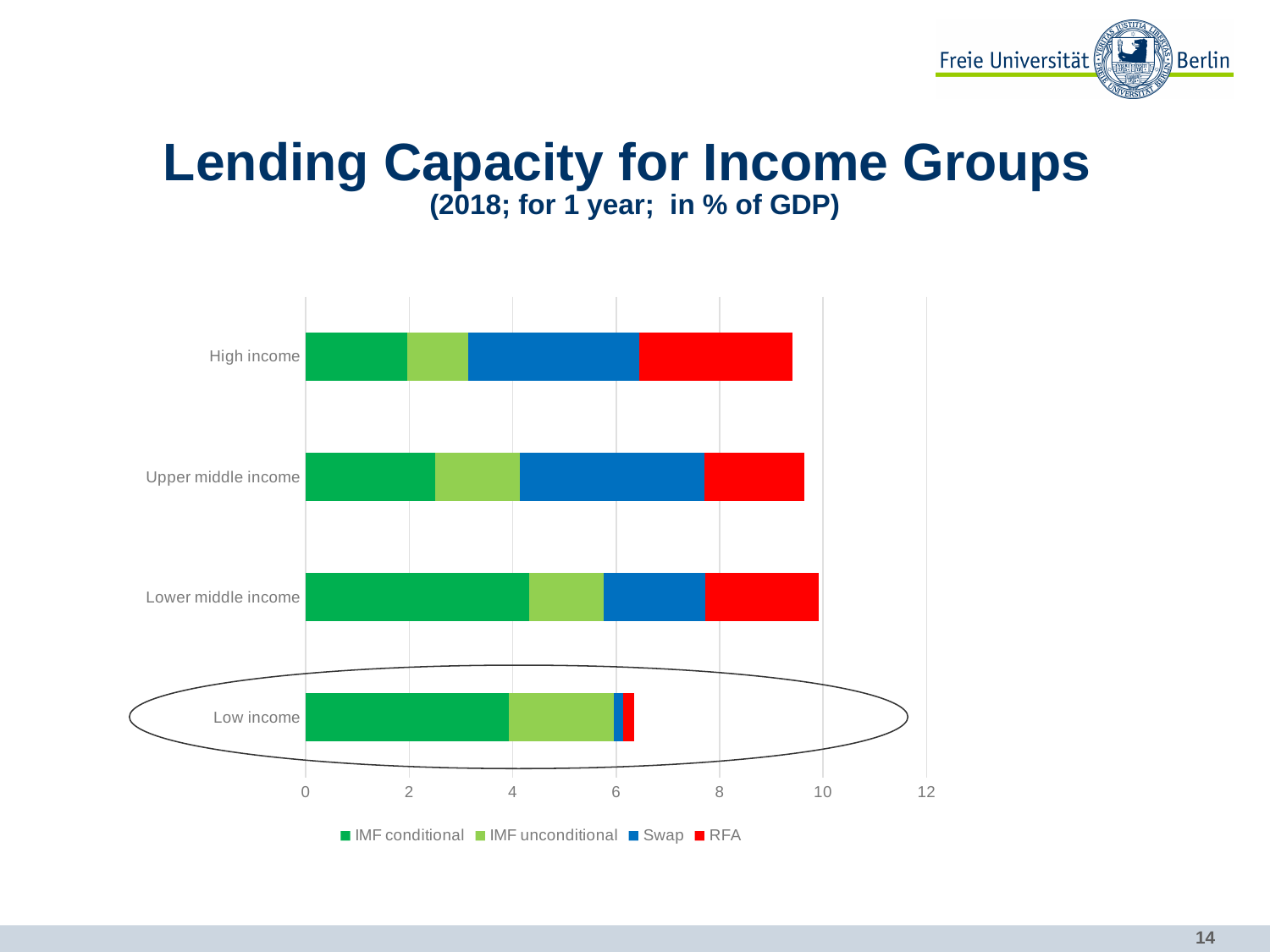
Is the total lending capacity for High income greater or less than 10? less Which income group is circled on the chart? Low income Which income group has a larger RFA segment, Lower middle income or Low income? Lower middle income What is the title of the chart? Lending Capacity for Income Groups How many income groups are shown on the chart? 4 Which income group has a larger Swap segment, High income or Low income? High income What kind of chart is shown on the slide? bar chart Is the total lending capacity for Low income greater or less than 8? less Is the total lending capacity for Lower middle income greater or less than 8? greater Which income group has the lowest total lending capacity? Low income Which has a larger total lending capacity, High income or Low income? High income How many series does the legend list? 4